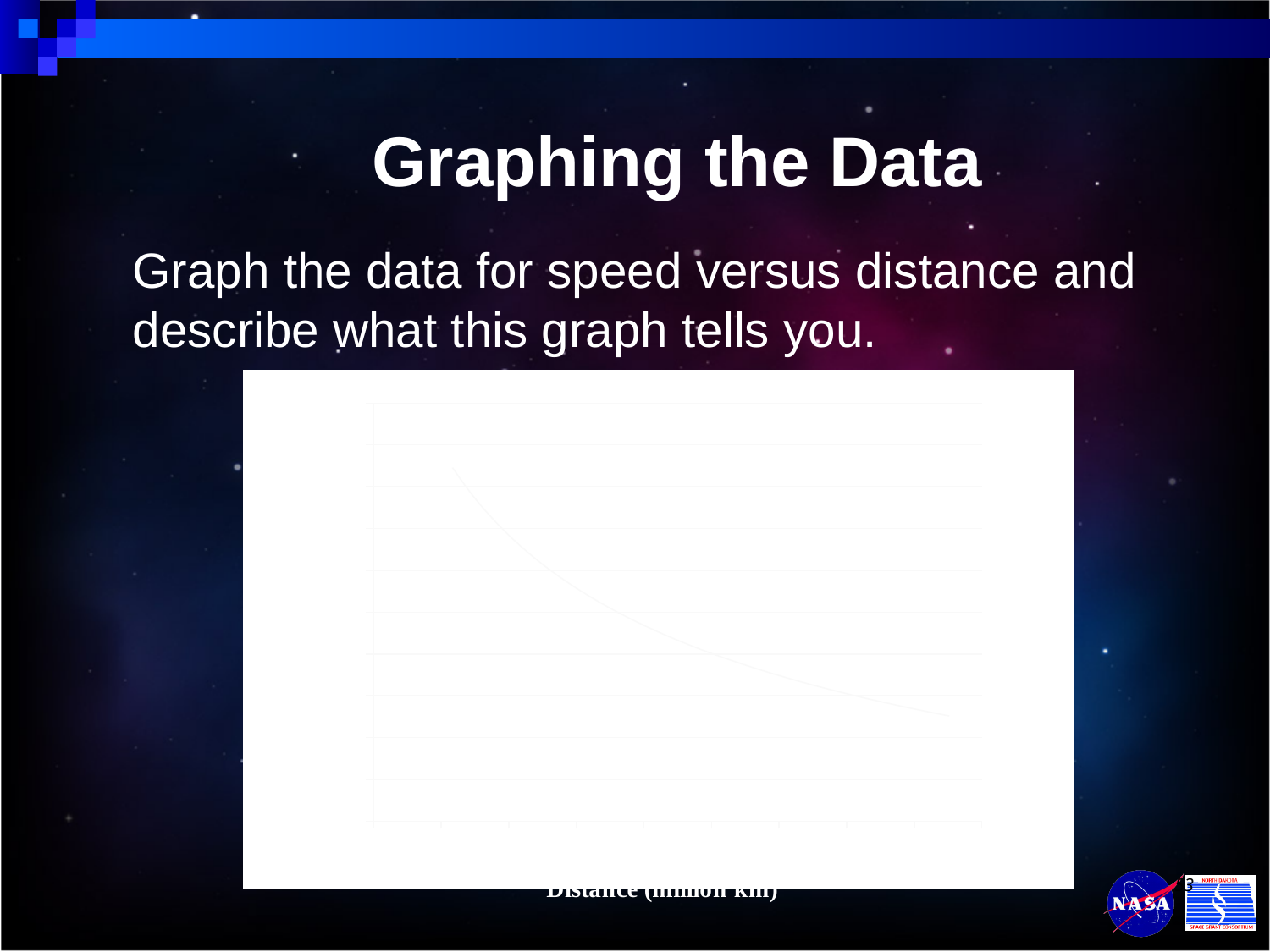
What is the label on the x axis of the chart? Distance (million km) What kind of chart is shown on the slide? line chart Do the plotted values rise or fall as you move along the x axis from left to right? fall